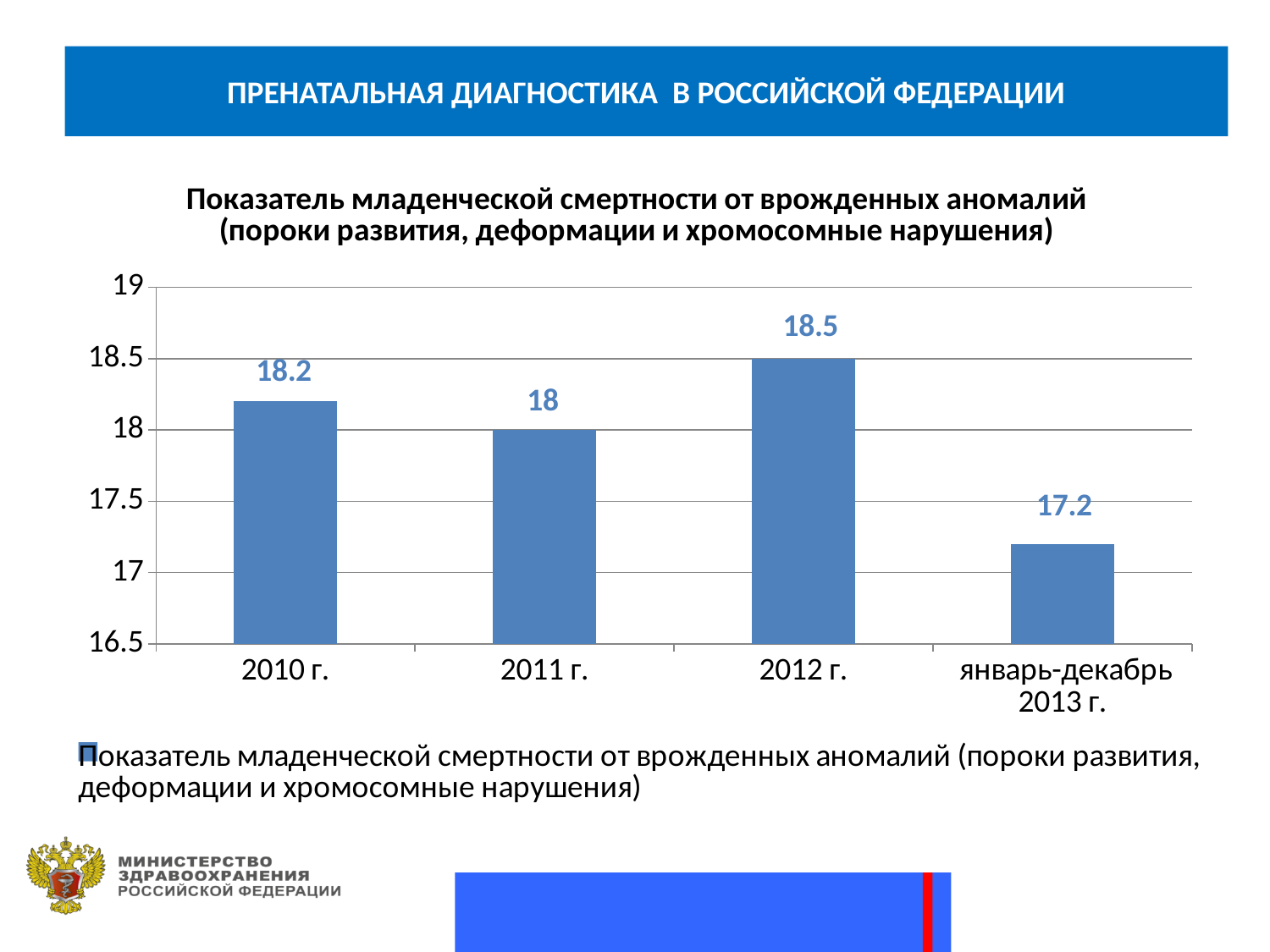
Which category has the highest value? 2012 г. What is the value for 2012 г.? 18.5 Which is larger, the value for 2010 г. or the value for 2011 г.? 2010 г. Which category has the lowest value? январь-декабрь 2013 г. What is the difference between the values for 2012 г. and январь-декабрь 2013 г.? 1.3 What is the title of the chart? Показатель младенческой смертности от врожденных аномалий (пороки развития, деформации и хромосомные нарушения) What kind of chart is shown on the slide? bar chart What is the value for январь-декабрь 2013 г.? 17.2 How many categories are shown on the x axis? 4 What is the value for 2010 г.? 18.2 What is the value for 2011 г.? 18 Is the value for январь-декабрь 2013 г. greater or less than 17.5? less